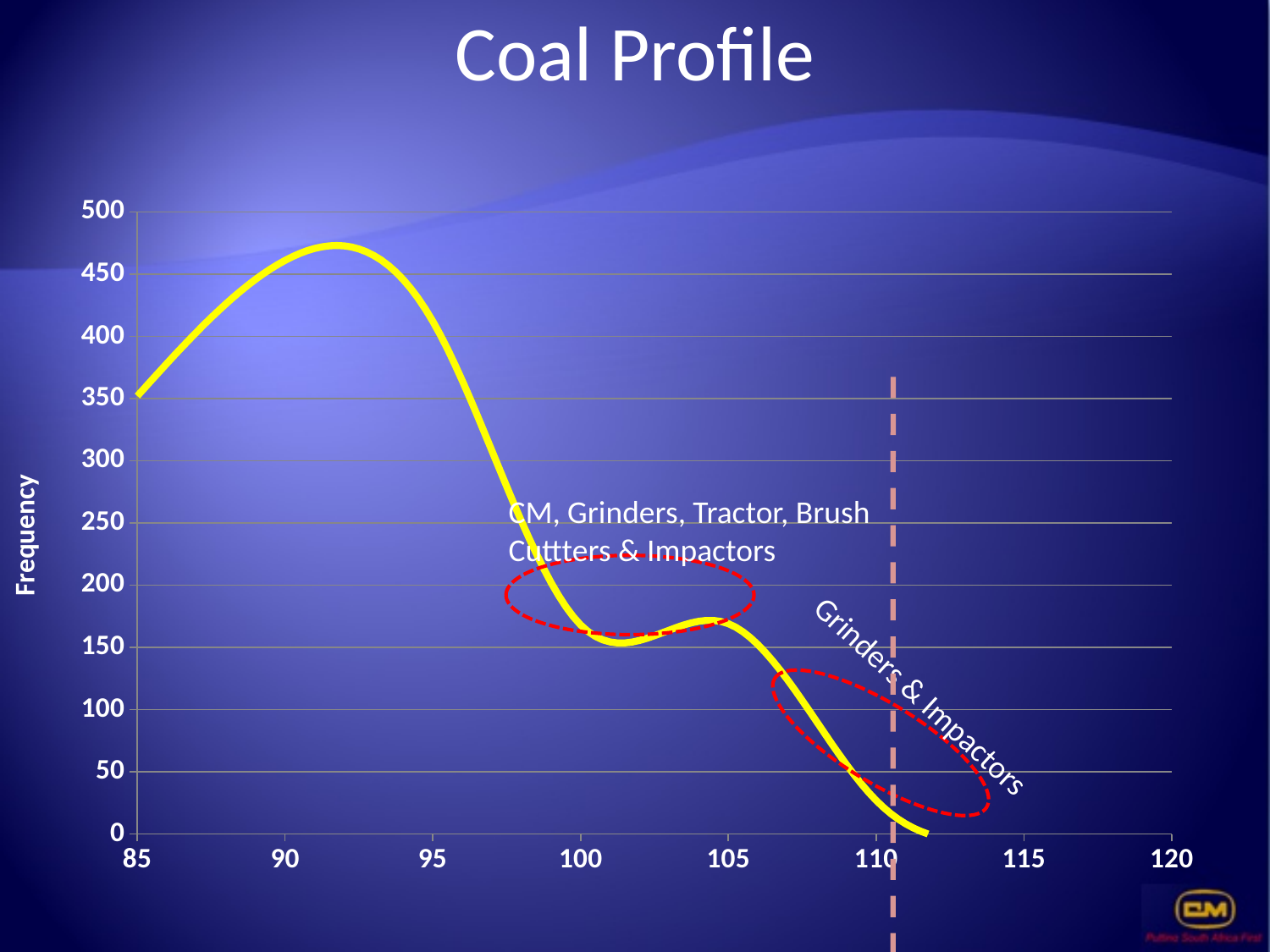
What is the label of the vertical axis? Frequency Is the value at x = 100 greater or less than 200? less Is the value at x = 110 greater or less than 100? less What is the title of the chart? Coal Profile Is the peak value of the line greater or less than 450? greater Does the line rise or fall between x = 95 and x = 100? fall Does the line rise or fall between x = 85 and x = 90? rise What kind of chart is shown on the slide? line chart Is the value at x = 90 larger or smaller than the value at x = 105? larger